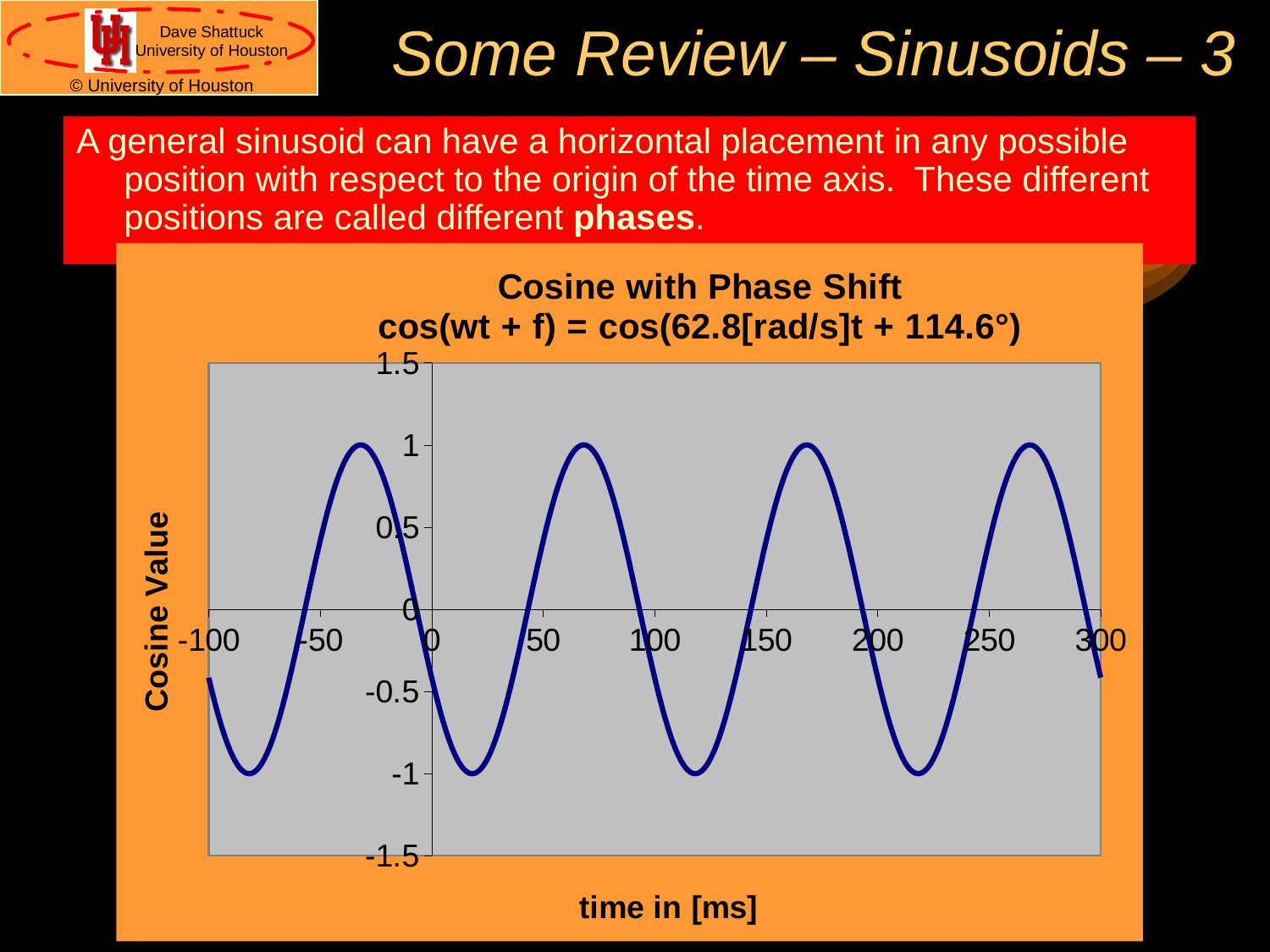
Is the value of the curve at time 20 ms greater or less than -0.5? less What is the maximum value reached by the plotted curve? 1 What kind of chart is shown on the slide? line chart Is the value of the curve at time 100 ms greater or less than 0? less How many peaks (maxima) of the curve are visible in the plotted range? 4 Is the value of the curve at time -50 ms greater or less than 0? greater What is the title of the chart? Cosine with Phase Shift cos(wt + f) = cos(62.8[rad/s]t + 114.6°) What is the minimum value reached by the plotted curve? -1 How many lines are plotted on the chart? 1 What is the label of the x axis of the chart? time in [ms]